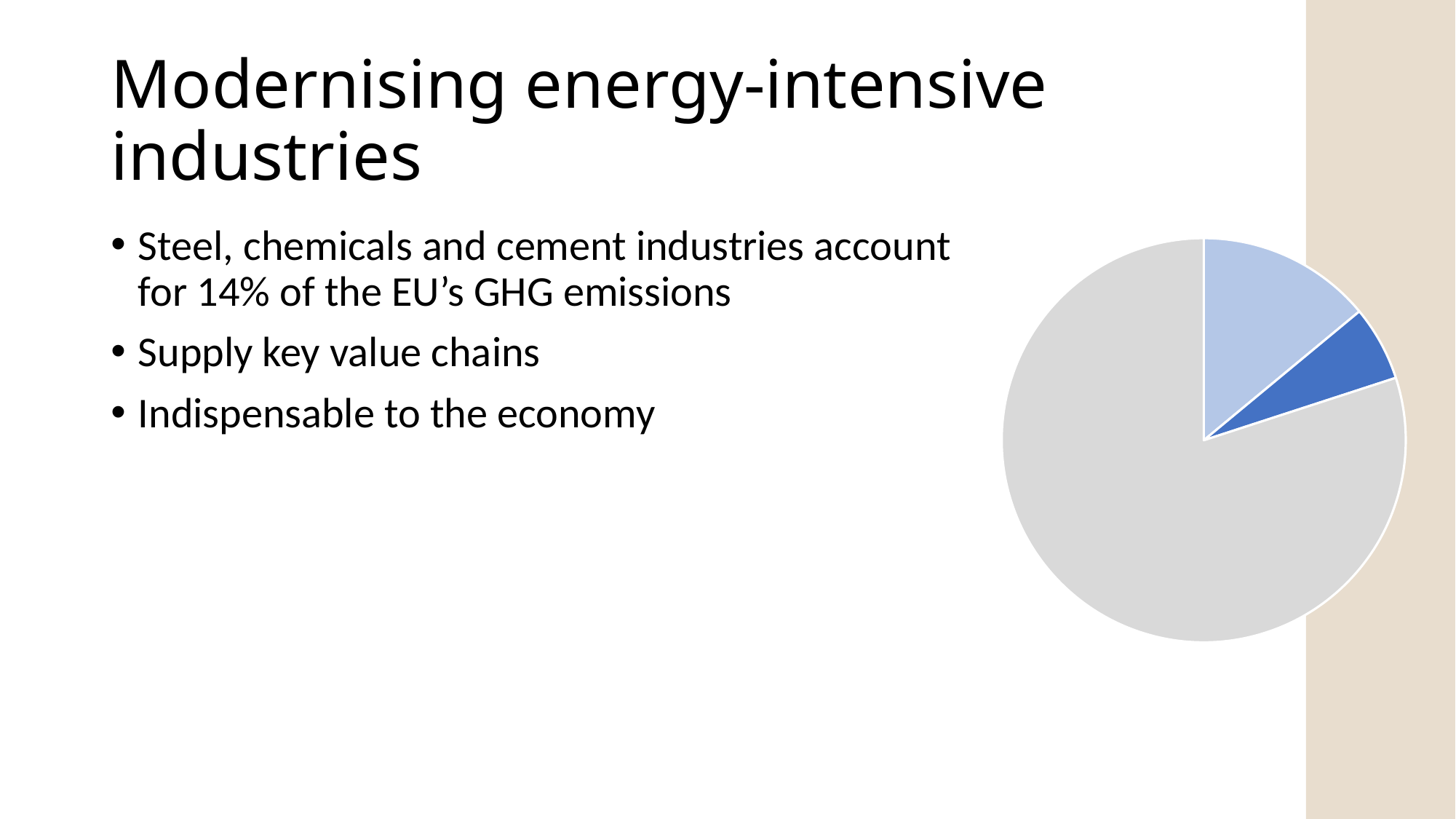
Does the pie chart show data labels on its slices? No In the pie chart, is the grey slice or the light blue slice larger? grey How many slices does the pie chart have? 3 Does the pie chart display a legend? No Which colour slice is the smallest in the pie chart? dark blue Which colour slice is the largest in the pie chart? grey What kind of chart is shown on the right of the slide? pie chart In the pie chart, is the light blue slice or the dark blue slice larger? light blue